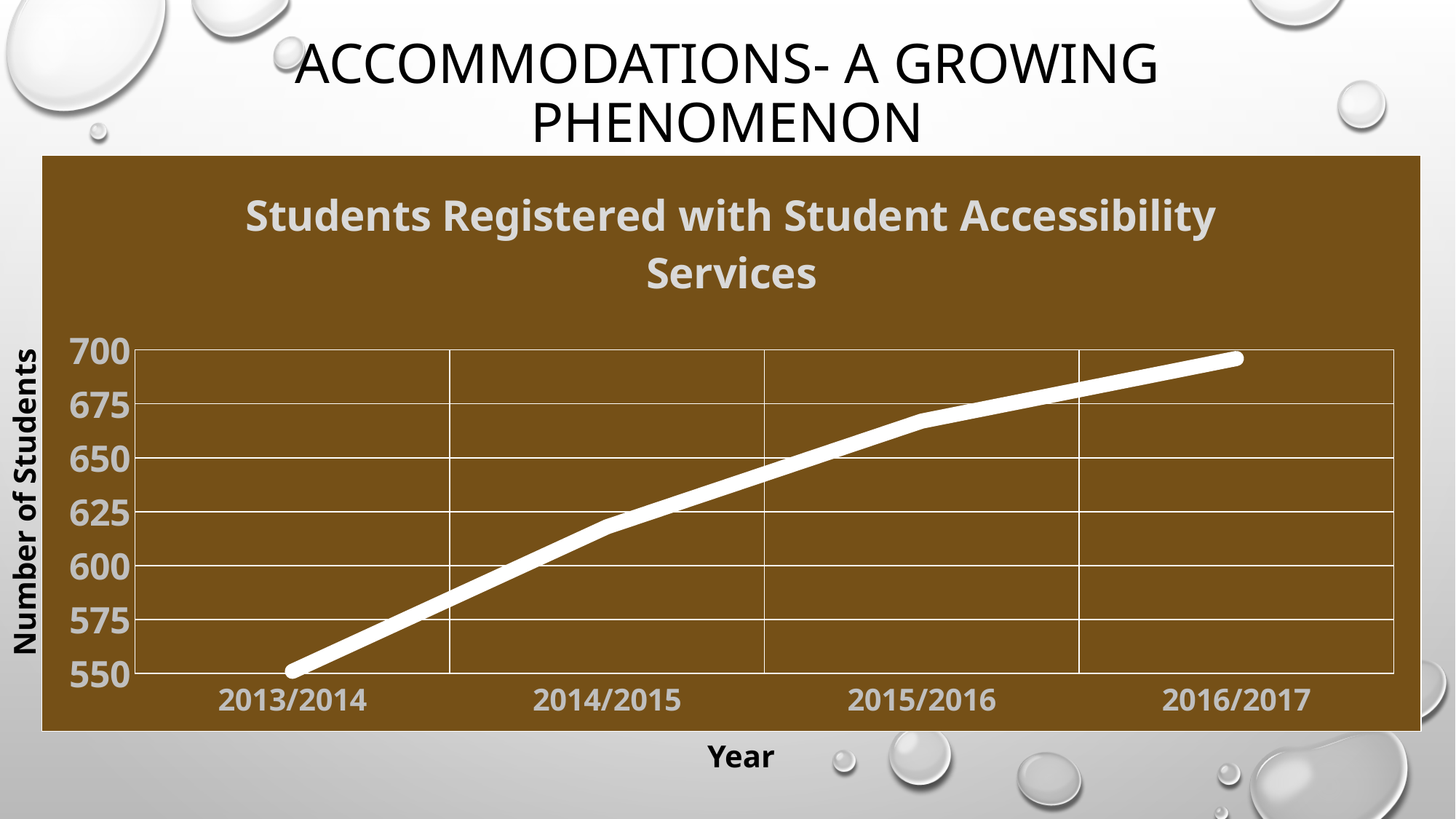
What is the title of the chart? Students Registered with Student Accessibility Services Which year has the highest number of students registered? 2016/2017 Is the value for 2015/2016 greater or less than 650? greater What kind of chart is shown on the slide? line chart Is the value for 2014/2015 greater or less than 600? greater Do the values rise or fall from 2013/2014 to 2016/2017? rise Which is larger, the value for 2015/2016 or the value for 2014/2015? 2015/2016 What is the label of the vertical axis? Number of Students How many years are plotted on the x axis of the chart? 4 Which year has the lowest number of students registered? 2013/2014 Is the value for 2014/2015 greater or less than 625? less